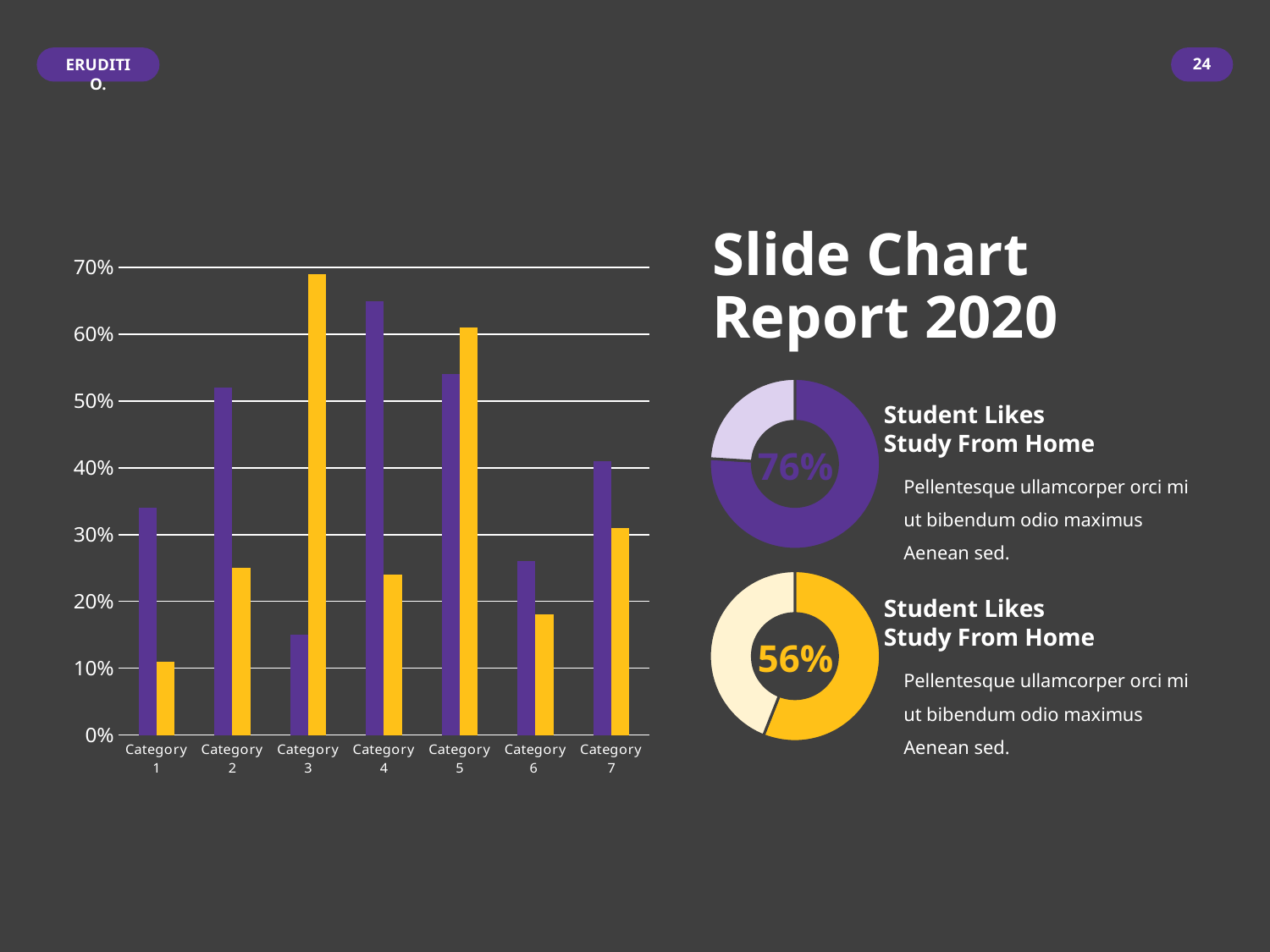
What percentage is shown in the centre of the upper (purple) donut chart on the right? 76% In the bar chart on the left, which category has the tallest purple bar? Category 4 In the bar chart on the left, which is taller for Category 5, the purple bar or the yellow bar? the yellow bar In the bar chart on the left, is the yellow bar for Category 6 greater or less than 20%? less In the bar chart on the left, which category has the tallest yellow bar? Category 3 In the bar chart on the left, which category has the shortest purple bar? Category 3 How many categories are shown on the x axis of the bar chart on the left? 7 What kind of chart is the large chart on the left of the slide? bar chart What percentage is shown in the centre of the lower (yellow) donut chart on the right? 56% In the bar chart on the left, which category has the shortest yellow bar? Category 1 In the bar chart on the left, is the purple bar for Category 2 greater or less than 50%? greater